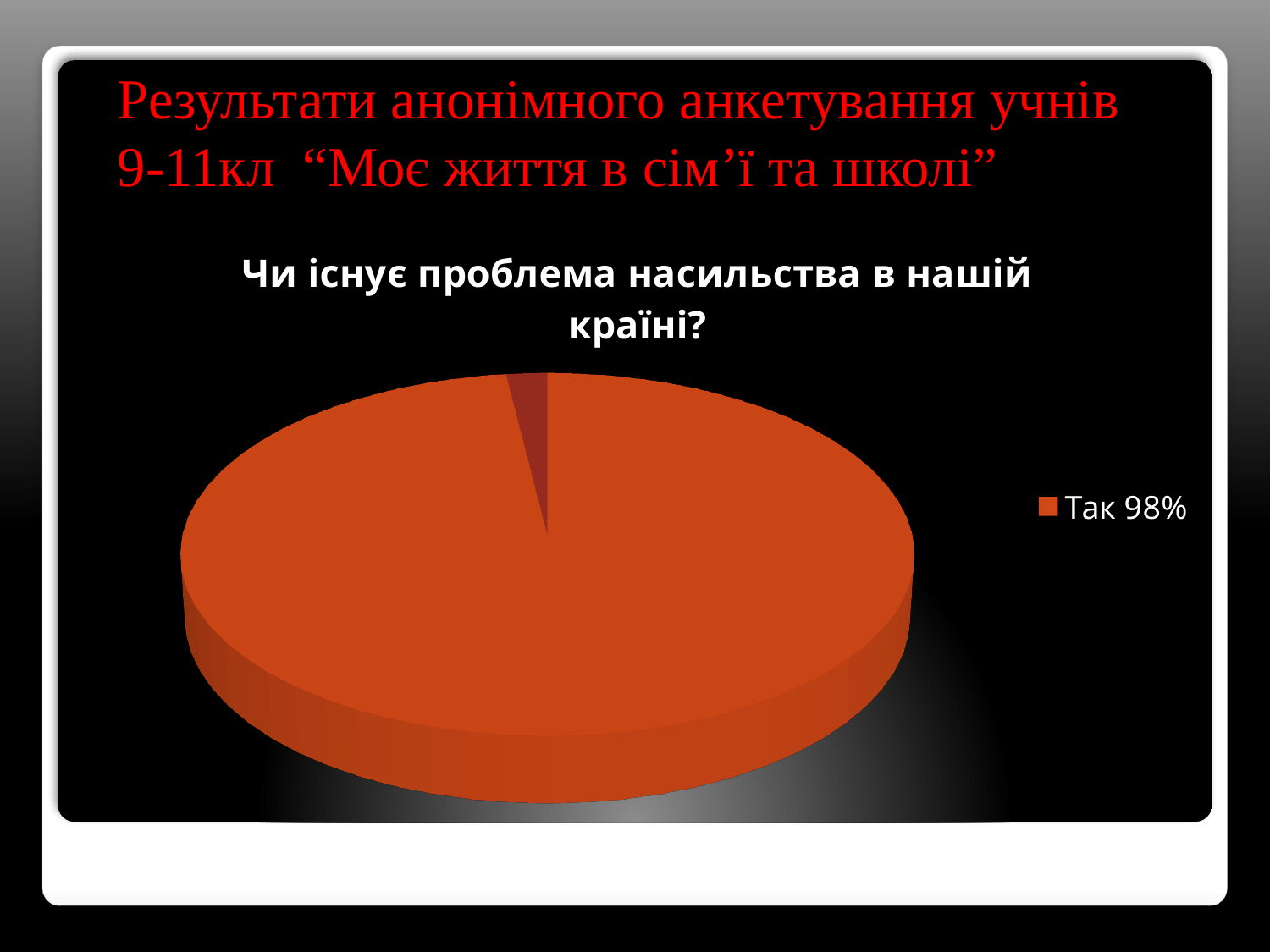
What is the title of the pie chart? Чи існує проблема насильства в нашій країні? What kind of chart is shown on the slide? pie chart What label is shown in the legend of the pie chart? Так 98% How many entries does the legend of the pie chart list? 1 What share of the pie does the "Так" slice represent? 98% How many slices are visible in the pie chart? 2 Which slice takes up the largest part of the pie? Так